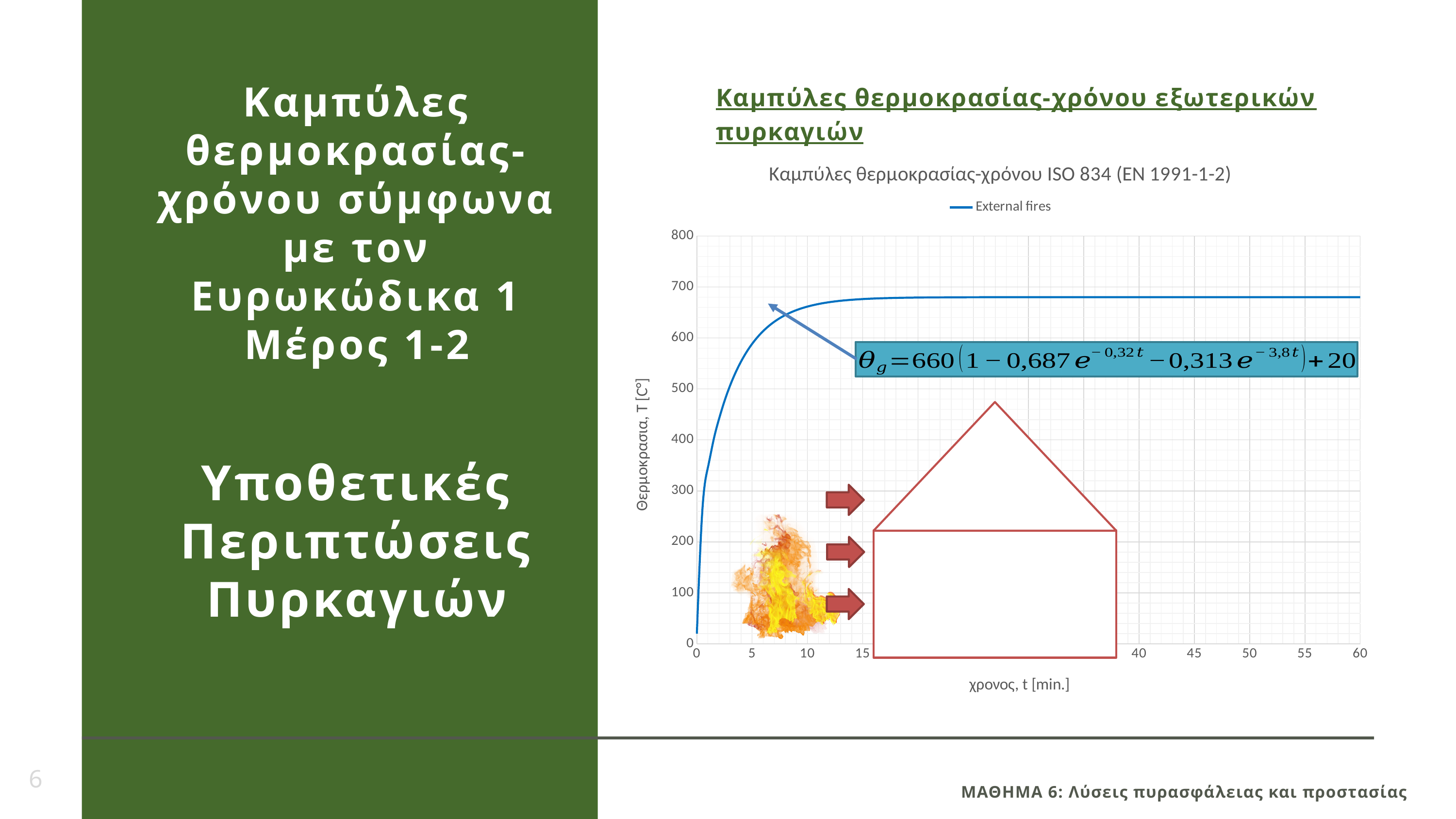
What is the title of the chart? Καμπύλες θερμοκρασίας-χρόνου ISO 834 (EN 1991-1-2) Is the value of the External fires curve at 30 minutes greater or less than 500? greater What is the maximum value shown on the x axis of the chart? 60 What is the name of the series shown in the chart legend? External fires Is the value of the External fires curve at 60 minutes greater or less than 700? less What kind of chart is shown on the slide? line chart Is the value of the External fires curve at 10 minutes greater or less than 600? greater Does the External fires curve rise or fall as time increases from 0 to 10 minutes? rise How many series does the chart legend list? 1 Which is larger, the value of the External fires curve at 2 minutes or at 20 minutes? at 20 minutes